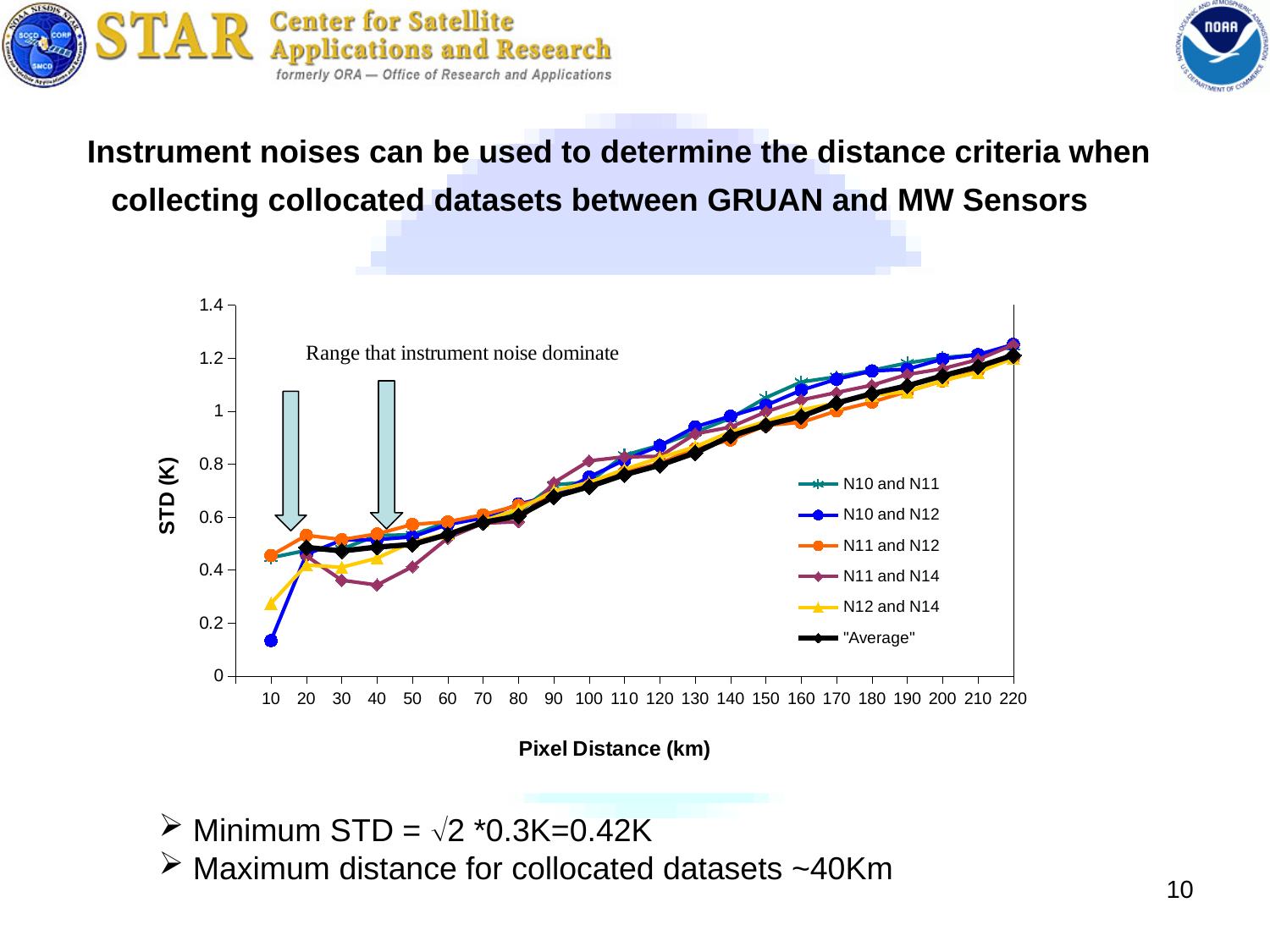
What kind of chart is shown on the slide? line chart What is the label of the chart's y axis? STD (K) Is the value for N10 and N12 at 10 km greater or less than 0.2? less Is the value for N12 and N14 at 10 km greater or less than 0.4? less Which series has the lowest value at 10 km? N10 and N12 How many pixel distance values are marked along the x axis of the chart? 22 Is the value for N11 and N14 at 40 km greater or less than 0.4? less At 10 km, which is larger: the value for N11 and N12 or the value for N10 and N12? N11 and N12 Do the "Average" values rise or fall as pixel distance increases along the x axis? rise What is the label of the chart's x axis? Pixel Distance (km) How many series does the chart's legend list? 6